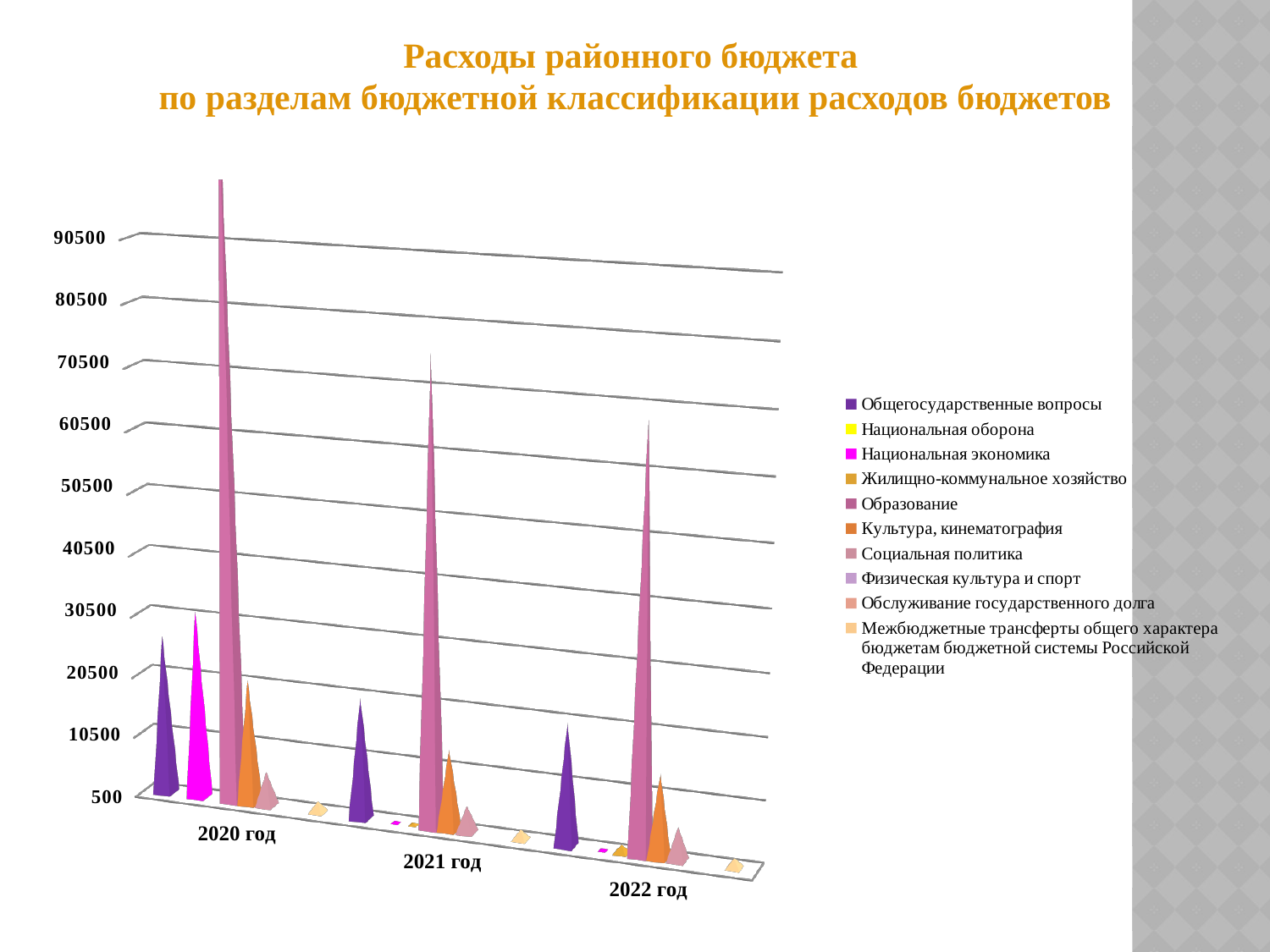
How many years (categories) are shown on the x axis? 3 Do the values for Образование rise or fall from 2020 год to 2022 год? fall Which series has the highest value in 2020 год? Образование Which is larger: Национальная экономика in 2020 год or in 2021 год? 2020 год Is the value for Образование in 2020 год greater or less than 90500? greater How many series does the legend list? 10 What kind of chart is shown on the slide? Bar chart Which series is shown in yellow in the legend? Национальная оборона Is the value for Общегосударственные вопросы in 2020 год greater or less than 20500? greater Which is larger: Образование in 2020 год or in 2022 год? 2020 год What is the title of the chart? Расходы районного бюджета по разделам бюджетной классификации расходов бюджетов